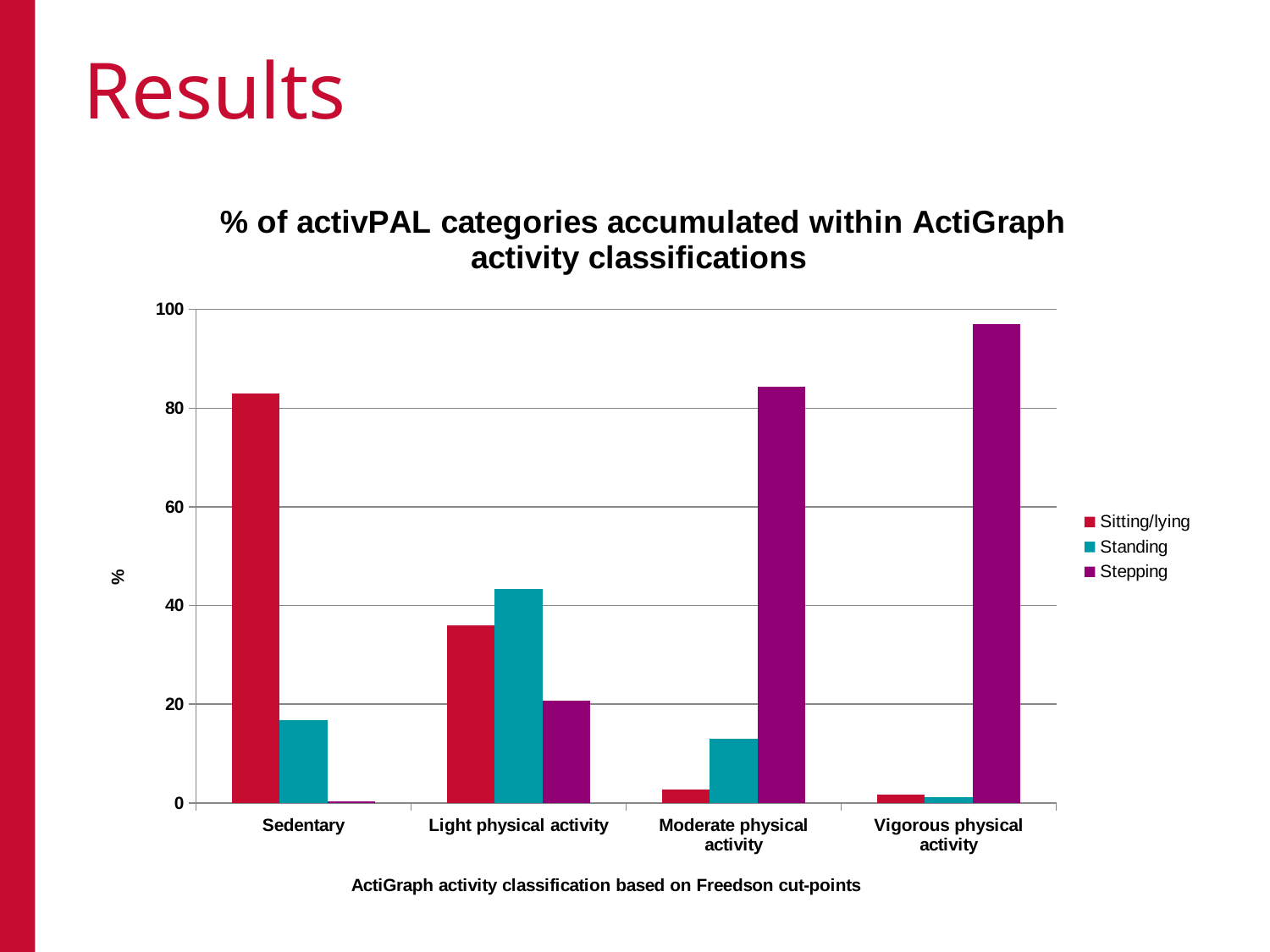
Which ActiGraph classification has the lowest Stepping value? Sedentary Is the Stepping value for Moderate physical activity greater or less than 80? greater How many series does the legend list? 3 What is the label of the x axis? ActiGraph activity classification based on Freedson cut-points Is the Sitting/lying value for Sedentary greater or less than 80? greater How many ActiGraph activity classifications are shown on the x axis? 4 Which ActiGraph classification has the highest Stepping value? Vigorous physical activity For Light physical activity, which is larger: the Standing value or the Stepping value? Standing Is the Standing value for Light physical activity greater or less than 40? greater Which ActiGraph classification has the highest Standing value? Light physical activity What kind of chart is shown on the slide? bar chart Which ActiGraph classification has the highest Sitting/lying value? Sedentary